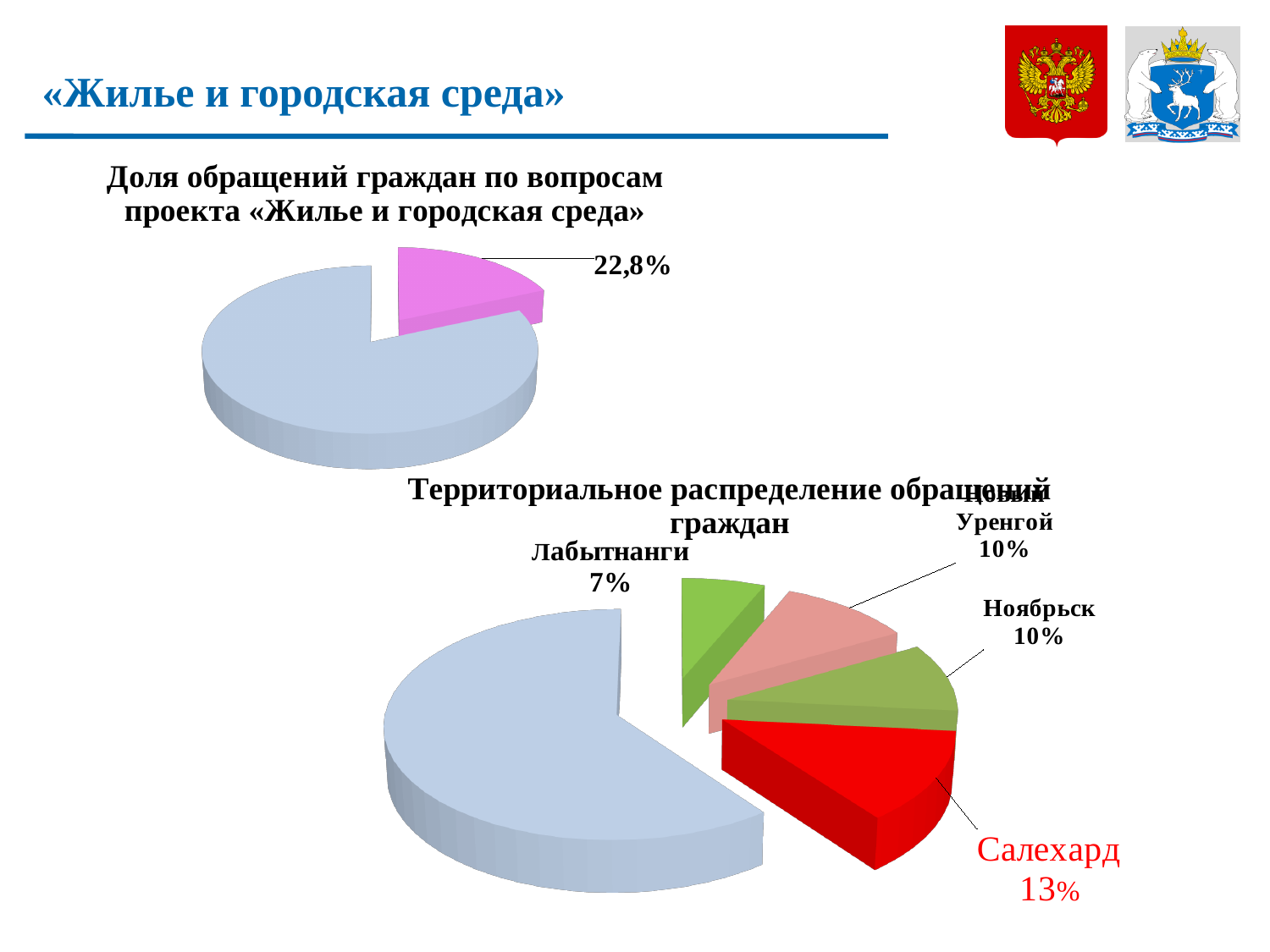
What type of chart is used for «Доля обращений граждан по вопросам проекта «Жилье и городская среда»»? Pie chart In the chart «Территориальное распределение обращений граждан», what is the share for Салехард? 13% In the chart «Территориальное распределение обращений граждан», which is larger: the share for Салехард or the share for Ноябрьск? Салехард In the chart «Территориальное распределение обращений граждан», which of the labeled cities has the largest share? Салехард In the chart «Территориальное распределение обращений граждан», which of the labeled cities has the smallest share? Лабытнанги In the chart «Территориальное распределение обращений граждан», what colour is the Салехард slice? Red In the chart «Доля обращений граждан по вопросам проекта «Жилье и городская среда»», how many slices does the pie have? 2 In the chart «Территориальное распределение обращений граждан», what is the share for Лабытнанги? 7% In the chart «Доля обращений граждан по вопросам проекта «Жилье и городская среда»», what share does the large unlabeled slice represent, given the labeled slice is 22,8%? 77,2% In the chart «Территориальное распределение обращений граждан», what is the share for Новый Уренгой? 10% In the chart «Доля обращений граждан по вопросам проекта «Жилье и городская среда»», what value is printed for the highlighted (pink) slice? 22,8% In the chart «Территориальное распределение обращений граждан», by how many percentage points does Салехард exceed Лабытнанги? 6